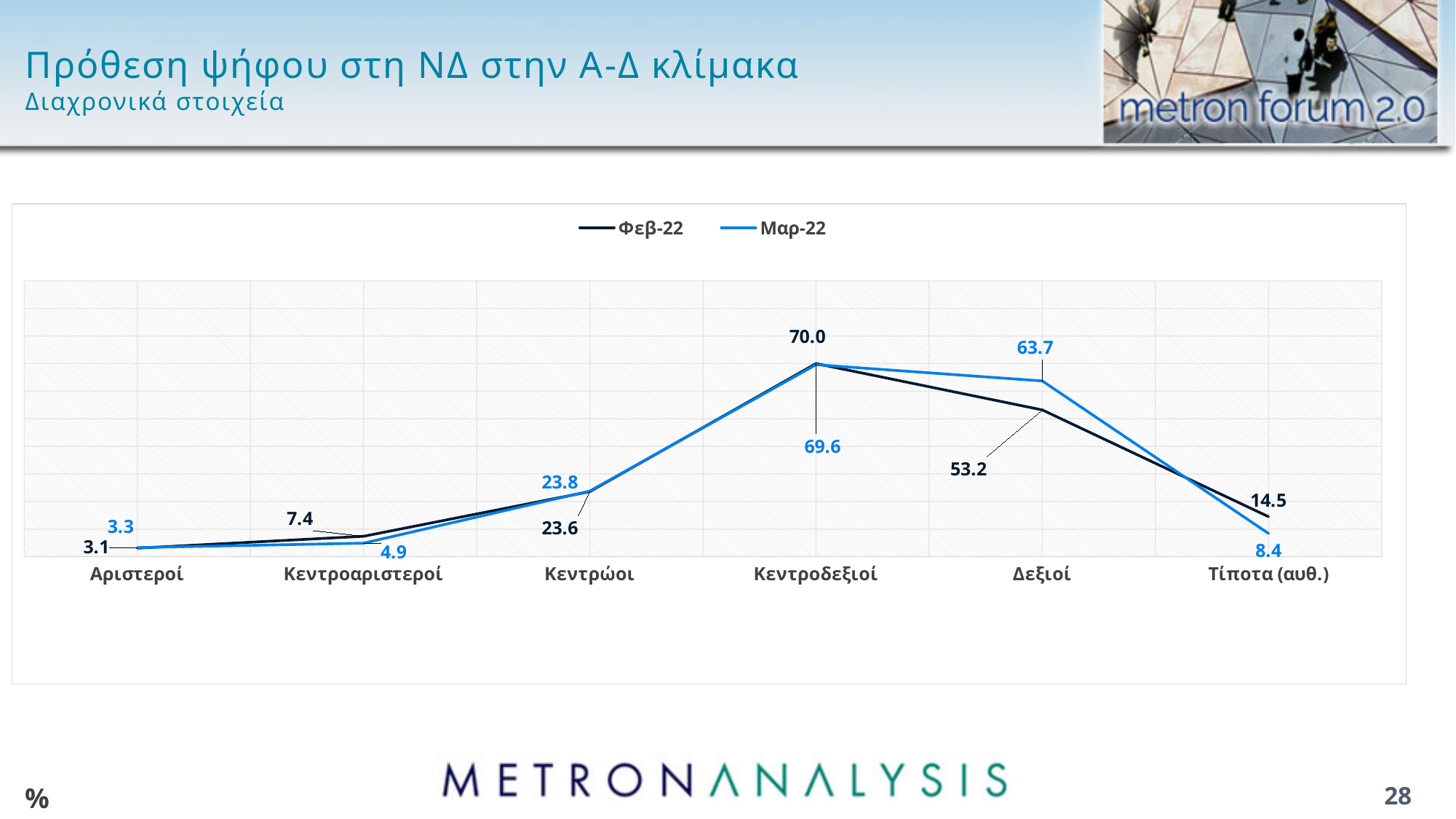
Which category has the lowest Φεβ-22 value? Αριστεροί For Τίποτα (αυθ.), which series has the larger value, Φεβ-22 or Μαρ-22? Φεβ-22 Which category has the highest Μαρ-22 value? Κεντροδεξιοί What kind of chart is shown on the slide? Line chart How many categories are shown on the x axis? 6 What is the Μαρ-22 value for Κεντροαριστεροί? 4.9 What is the Φεβ-22 value for Τίποτα (αυθ.)? 14.5 For Κεντροαριστεροί, which series has the larger value, Φεβ-22 or Μαρ-22? Φεβ-22 What is the Φεβ-22 value for Κεντροδεξιοί? 70.0 How many series does the legend list? 2 What is the difference between the Μαρ-22 and Φεβ-22 values for Δεξιοί? 10.5 What is the Μαρ-22 value for Δεξιοί? 63.7